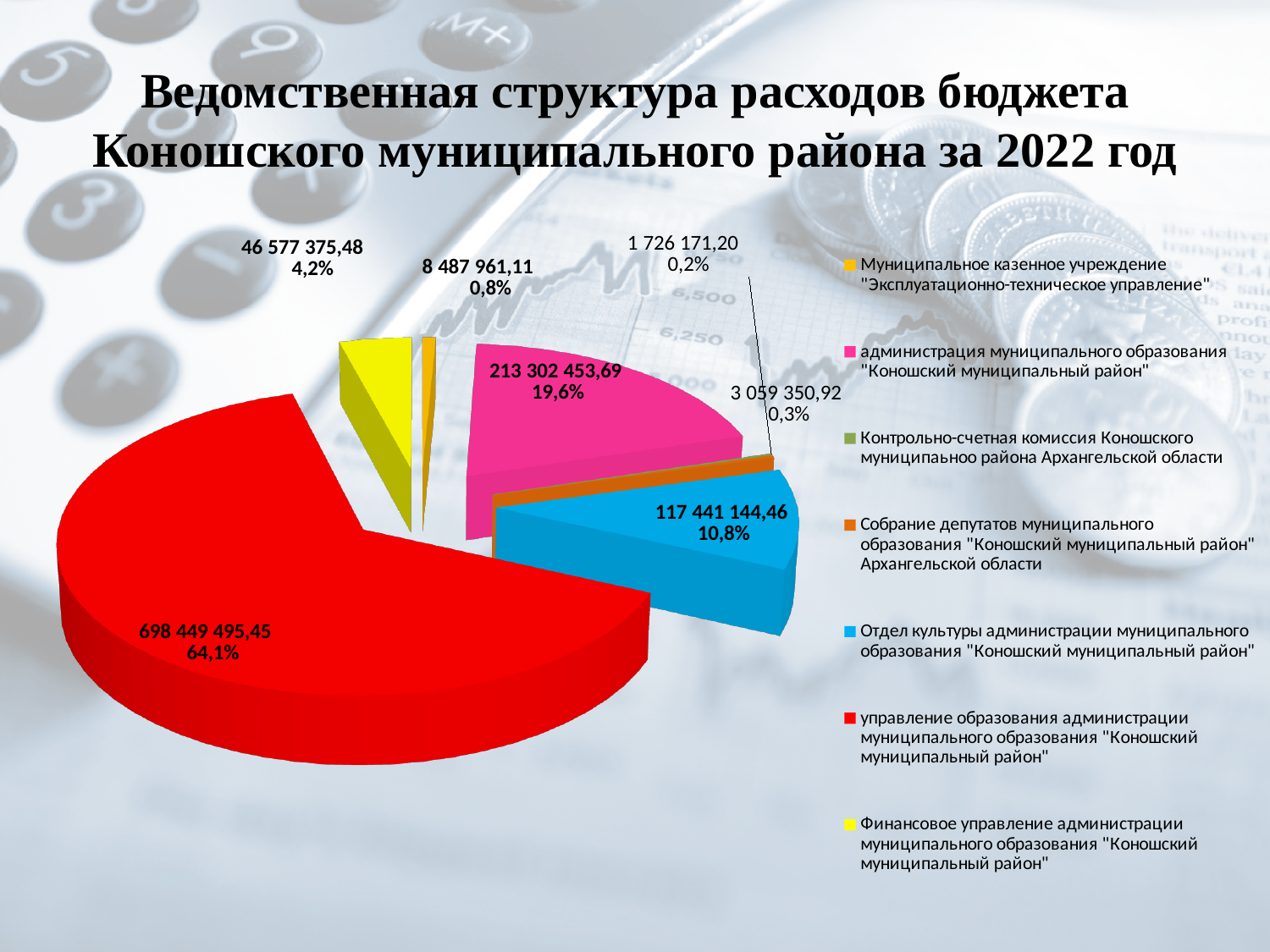
What is the value for управление образования администрации муниципального образования "Коношский муниципальный район"? 698 449 495,45 What share of the pie does управление образования администрации муниципального образования "Коношский муниципальный район" take? 64,1% What is the value for администрация муниципального образования "Коношский муниципальный район"? 213 302 453,69 What share of the pie does Отдел культуры администрации муниципального образования "Коношский муниципальный район" take? 10,8% Which is larger: the slice for администрация муниципального образования "Коношский муниципальный район" or the slice for Отдел культуры? администрация муниципального образования "Коношский муниципальный район" What colour is the slice for управление образования администрации муниципального образования "Коношский муниципальный район"? red How many slices does the pie chart have? 7 How many entries does the legend list? 7 What is the difference in percentage points between the share of администрация муниципального образования (19,6%) and the share of Отдел культуры (10,8%)? 8,8 What kind of chart is shown on the slide? pie chart Which category has the largest slice of the pie? управление образования администрации муниципального образования "Коношский муниципальный район" What is the value for Финансовое управление администрации муниципального образования "Коношский муниципальный район"? 46 577 375,48